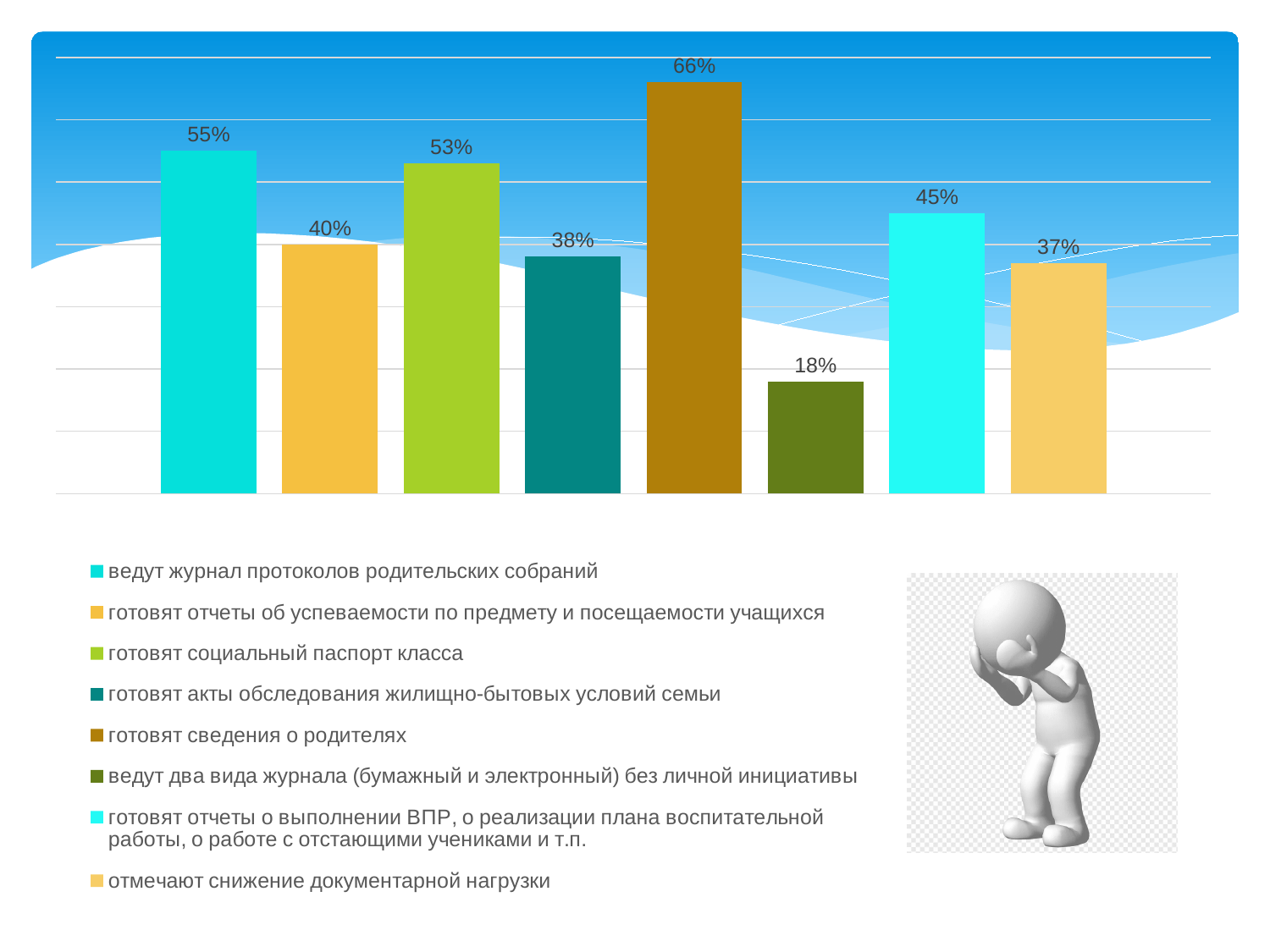
Which category has the highest value? готовят сведения о родителях Which category has the lowest value? ведут два вида журнала (бумажный и электронный) без личной инициативы What value is shown for "готовят сведения о родителях"? 66% What value is shown for "готовят социальный паспорт класса"? 53% What value is shown for "отмечают снижение документарной нагрузки"? 37% What value is shown for "ведут журнал протоколов родительских собраний"? 55% Which is larger: the value for "готовят акты обследования жилищно-бытовых условий семьи" or the value for "готовят отчеты о выполнении ВПР, о реализации плана воспитательной работы, о работе с отстающими учениками и т.п."? готовят отчеты о выполнении ВПР, о реализации плана воспитательной работы, о работе с отстающими учениками и т.п. What is the difference between the values for "готовят сведения о родителях" and "ведут два вида журнала (бумажный и электронный) без личной инициативы"? 48% How many entries does the legend list? 8 How many bars are plotted in the chart? 8 What kind of chart is shown on the slide? bar chart What is the difference between the values for "ведут журнал протоколов родительских собраний" and "готовят отчеты об успеваемости по предмету и посещаемости учащихся"? 15%